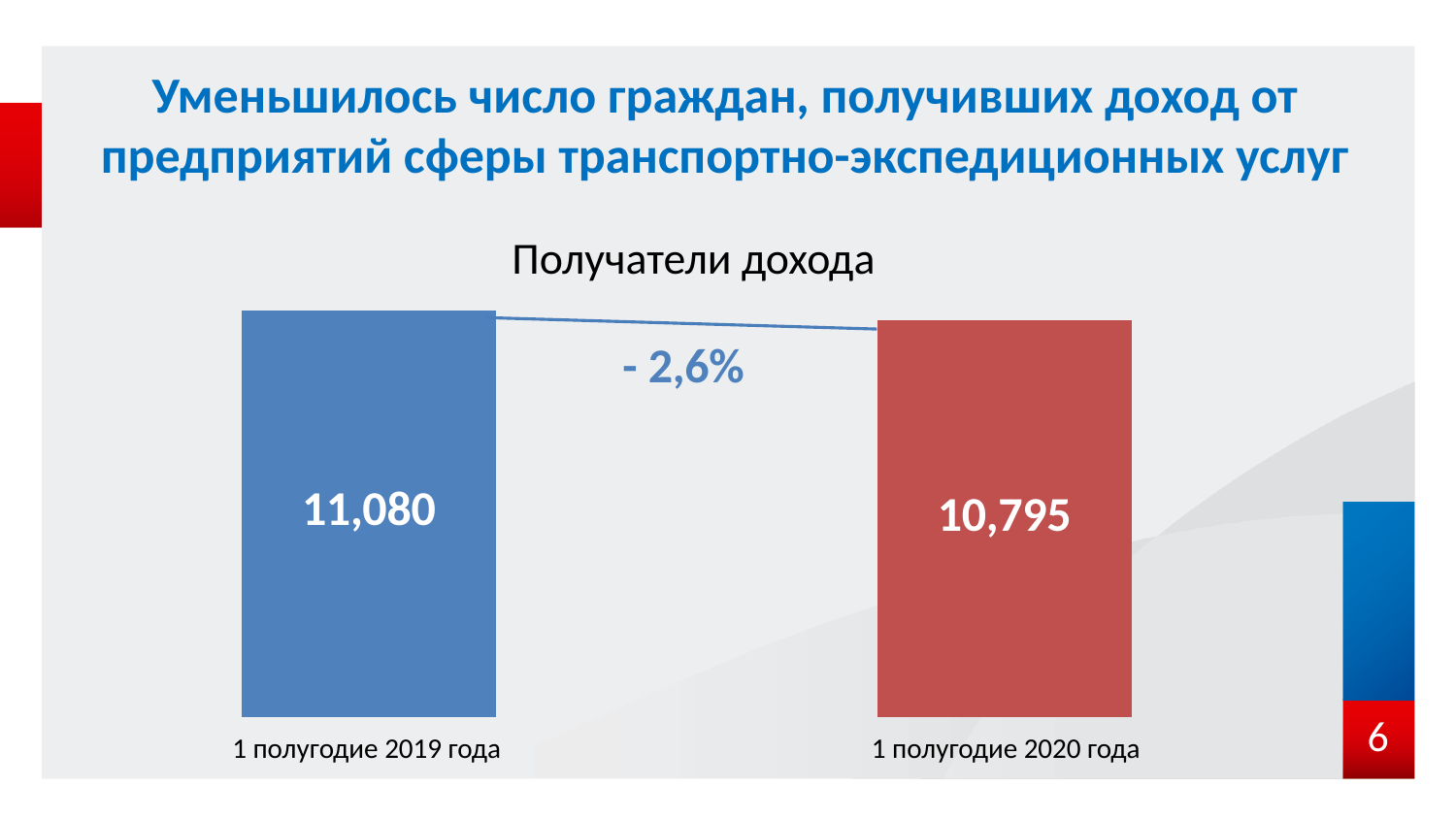
What is the title of the chart? Получатели дохода What is the value for 1 полугодие 2020 года? 10,795 What kind of chart is shown on the slide? Bar chart Which category has the highest value? 1 полугодие 2019 года Which is larger, the value for 1 полугодие 2019 года or for 1 полугодие 2020 года? 1 полугодие 2019 года How many categories are shown in the chart? 2 Which category has the lowest value? 1 полугодие 2020 года What is the value for 1 полугодие 2019 года? 11,080 What is the difference between the values for 1 полугодие 2019 года and 1 полугодие 2020 года? 285 What percentage change is shown between the two bars? - 2,6% Do the values rise or fall from 1 полугодие 2019 года to 1 полугодие 2020 года? Fall